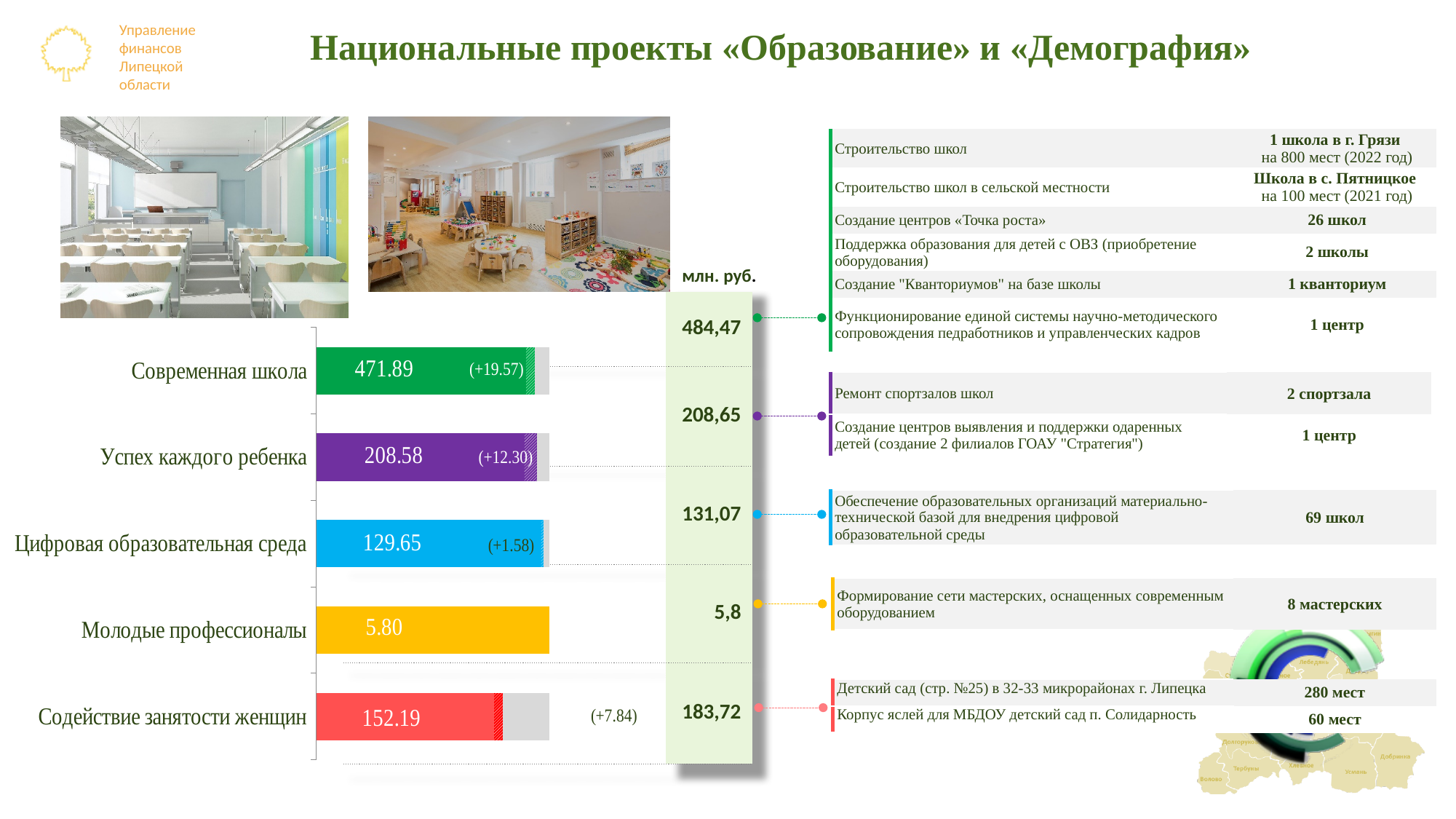
How many categories are plotted in the bar chart? 5 Which category has the highest bar value in the chart? Современная школа What value is shown on the bar for «Содействие занятости женщин»? 152.19 What kind of chart is used to show the national project values? Bar chart What value is shown on the bar for «Современная школа»? 471.89 What unit is indicated above the column of totals next to the chart? млн. руб. What value is shown on the bar for «Цифровая образовательная среда»? 129.65 Which category has the lowest bar value in the chart? Молодые профессионалы What value is shown on the bar for «Молодые профессионалы»? 5.80 What is the difference between the bar values for «Современная школа» and «Успех каждого ребенка»? 263.31 Which has a larger bar value: «Содействие занятости женщин» or «Цифровая образовательная среда»? Содействие занятости женщин What value is shown on the bar for «Успех каждого ребенка»? 208.58